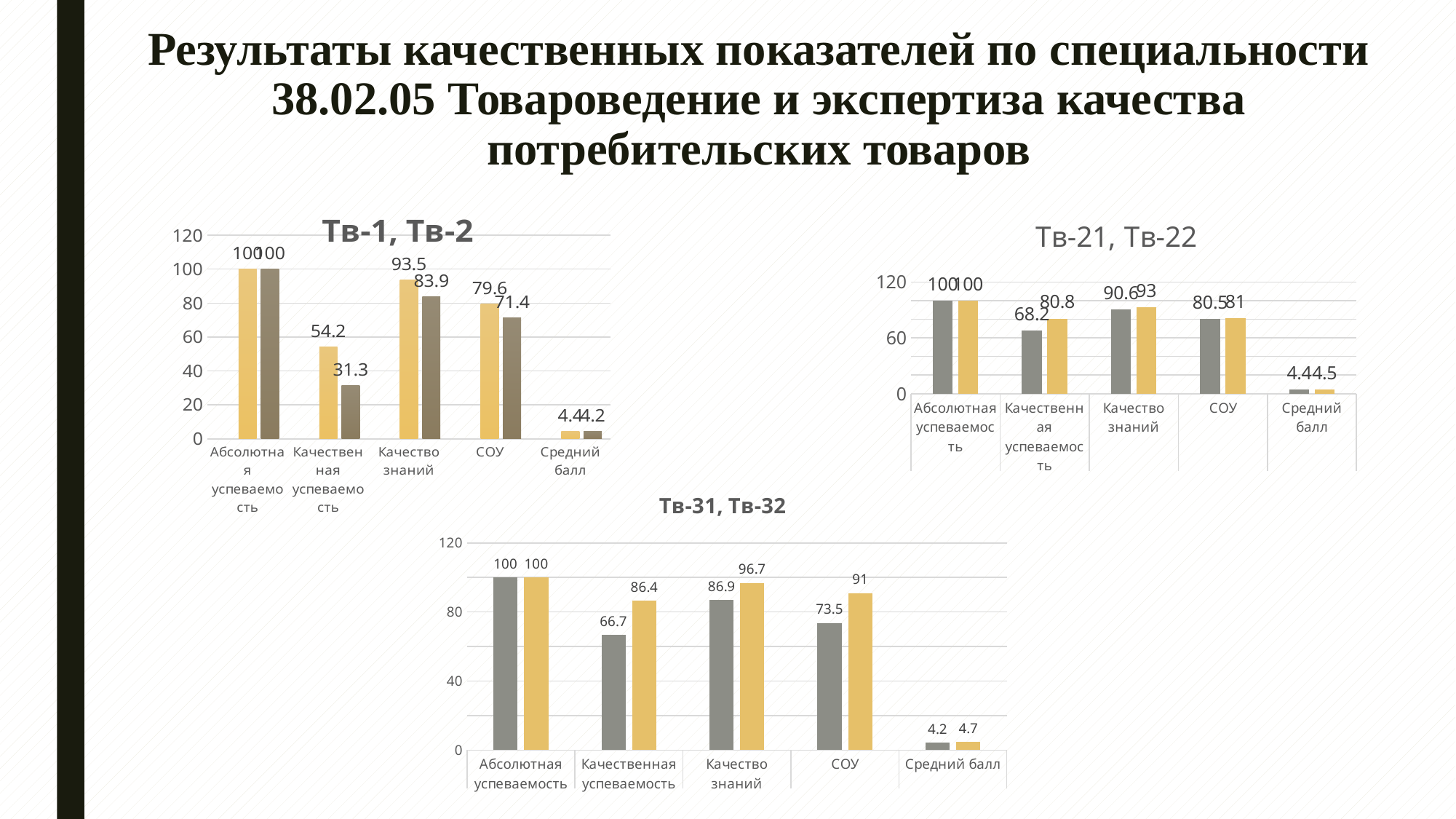
In the chart titled "Тв-31, Тв-32", what is the value of the grey bar for СОУ? 73.5 In the chart titled "Тв-21, Тв-22", what is the value of the grey bar for Качественная успеваемость? 68.2 In the chart titled "Тв-1, Тв-2", which category has the lowest values? Средний балл How many charts are shown on the slide? 3 What type of chart is the chart titled "Тв-21, Тв-22"? bar chart In the chart titled "Тв-31, Тв-32", what is the value of the yellow bar for Качество знаний? 96.7 In the chart titled "Тв-21, Тв-22", is the grey bar for Качественная успеваемость greater or less than 60? greater In the chart titled "Тв-31, Тв-32", what is the difference between the yellow and grey bars for Качественная успеваемость? 19.7 In the chart titled "Тв-1, Тв-2", what is the value of the yellow bar for Качественная успеваемость? 54.2 In the chart titled "Тв-31, Тв-32", which is larger for СОУ: the grey bar or the yellow bar? the yellow bar In the chart titled "Тв-1, Тв-2", what is the difference between the yellow and brown bars for Качественная успеваемость? 22.9 How many categories are shown on the x axis of the chart titled "Тв-31, Тв-32"? 5